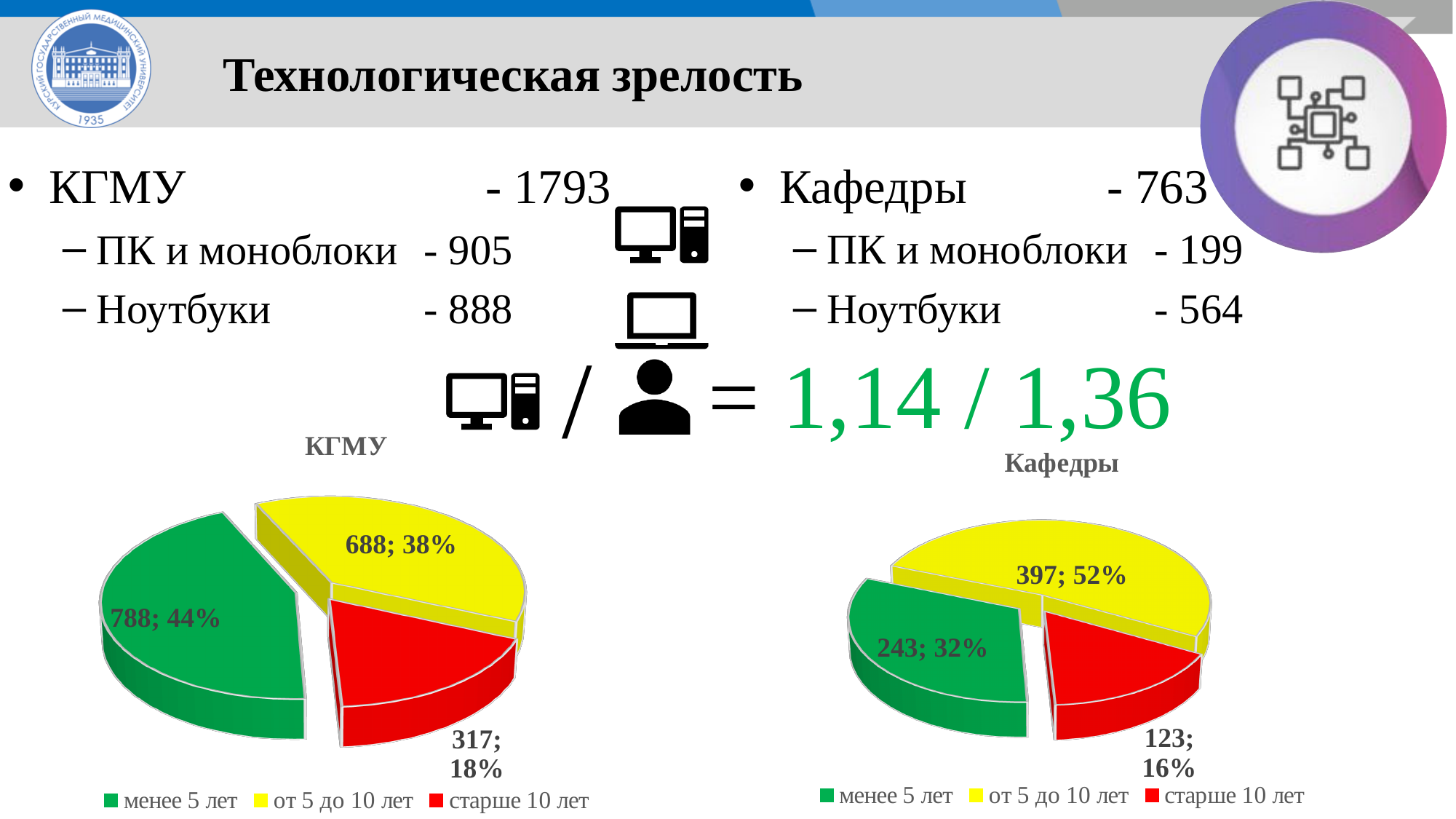
In the КГМУ chart, what value is shown for the 'менее 5 лет' slice? 788; 44% What type of chart is the КГМУ chart? pie chart How many slices does the Кафедры chart have? 3 Which is larger: the 'старше 10 лет' value in the КГМУ chart or the 'старше 10 лет' value in the Кафедры chart? КГМУ In the Кафедры chart, what value is shown for the 'от 5 до 10 лет' slice? 397; 52% In the Кафедры chart, what is the difference between the 'от 5 до 10 лет' value and the 'старше 10 лет' value? 274 In the КГМУ chart, which colour represents 'от 5 до 10 лет'? yellow In the Кафедры chart, what share of the pie does the 'менее 5 лет' slice have? 32% In the КГМУ chart, which category has the largest slice? менее 5 лет In the КГМУ chart, what is the difference between the 'менее 5 лет' value and the 'от 5 до 10 лет' value? 100 In the КГМУ chart, what share of the pie does the 'старше 10 лет' slice have? 18% In the Кафедры chart, which category has the smallest slice? старше 10 лет